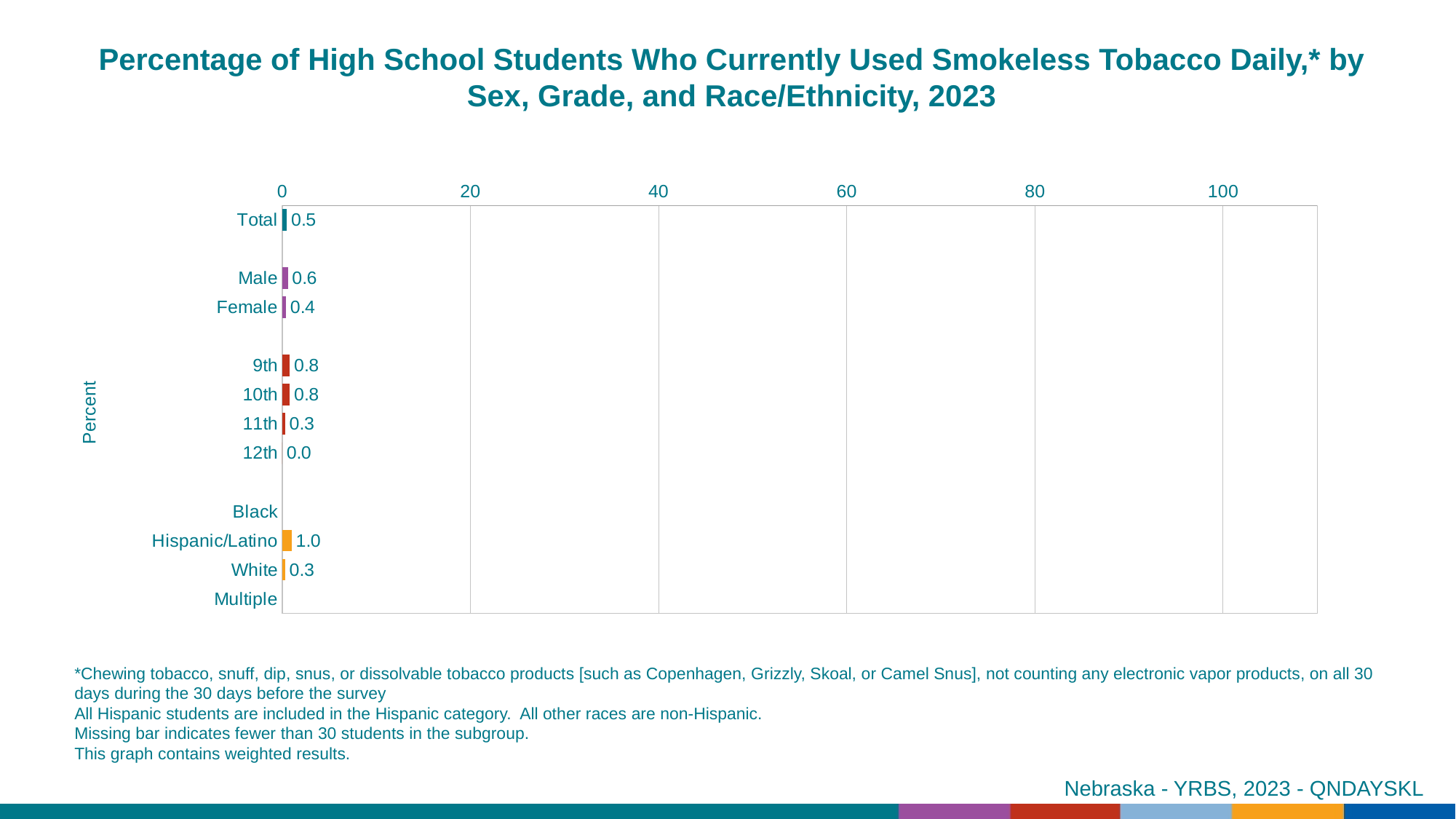
Is the value for Hispanic/Latino greater or less than 20? less What is the value for Male? 0.6 How many categories are listed on the vertical axis? 11 Which category has the highest value among those with a printed value? Hispanic/Latino What kind of chart is shown on the slide? bar chart What is the difference between the Male and Female values? 0.2 Which categories have no bar shown? Black and Multiple What is the value for Hispanic/Latino? 1.0 Which is larger, the value for 9th grade or the value for 11th grade? 9th What is the value for Total? 0.5 What is the value for 12th grade? 0.0 What is the label on the vertical axis? Percent